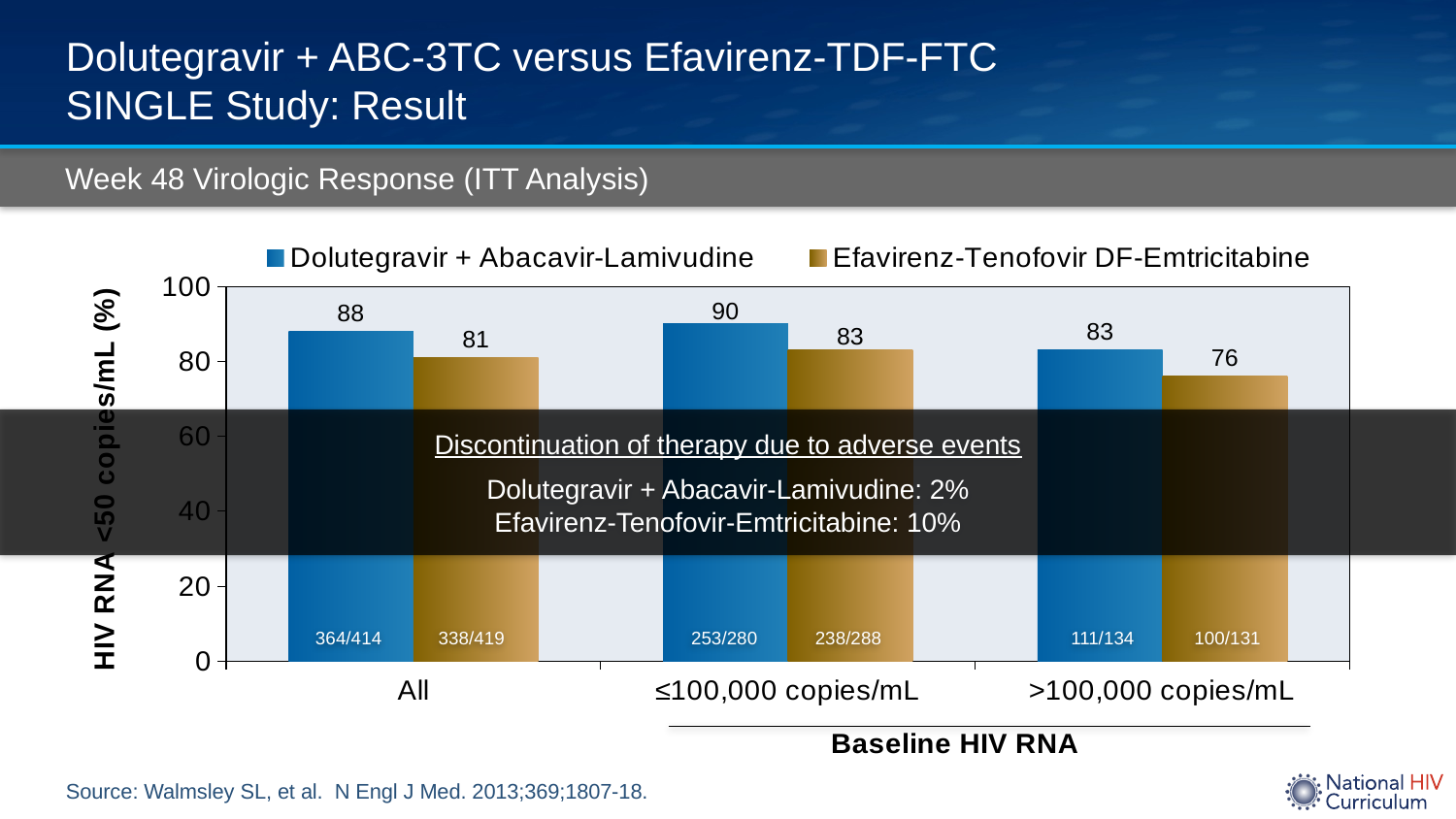
How many series does the legend list? 2 What is the value for Dolutegravir + Abacavir-Lamivudine in the All category? 88 How many baseline HIV RNA categories are shown on the x axis? 3 What is the value for Efavirenz-Tenofovir DF-Emtricitabine in the ≤100,000 copies/mL category? 83 What is the difference between the Dolutegravir + Abacavir-Lamivudine and Efavirenz-Tenofovir DF-Emtricitabine values in the All category? 7 What is the label of the y axis? HIV RNA <50 copies/mL (%) Which baseline HIV RNA category has the lowest value for Efavirenz-Tenofovir DF-Emtricitabine? >100,000 copies/mL Is the value for Efavirenz-Tenofovir DF-Emtricitabine in the All category greater or less than 80? greater What kind of chart is shown on the slide? Bar chart In the >100,000 copies/mL category, which series has the larger value? Dolutegravir + Abacavir-Lamivudine Which baseline HIV RNA category has the highest value for Dolutegravir + Abacavir-Lamivudine? ≤100,000 copies/mL What is the value for Efavirenz-Tenofovir DF-Emtricitabine in the >100,000 copies/mL category? 76